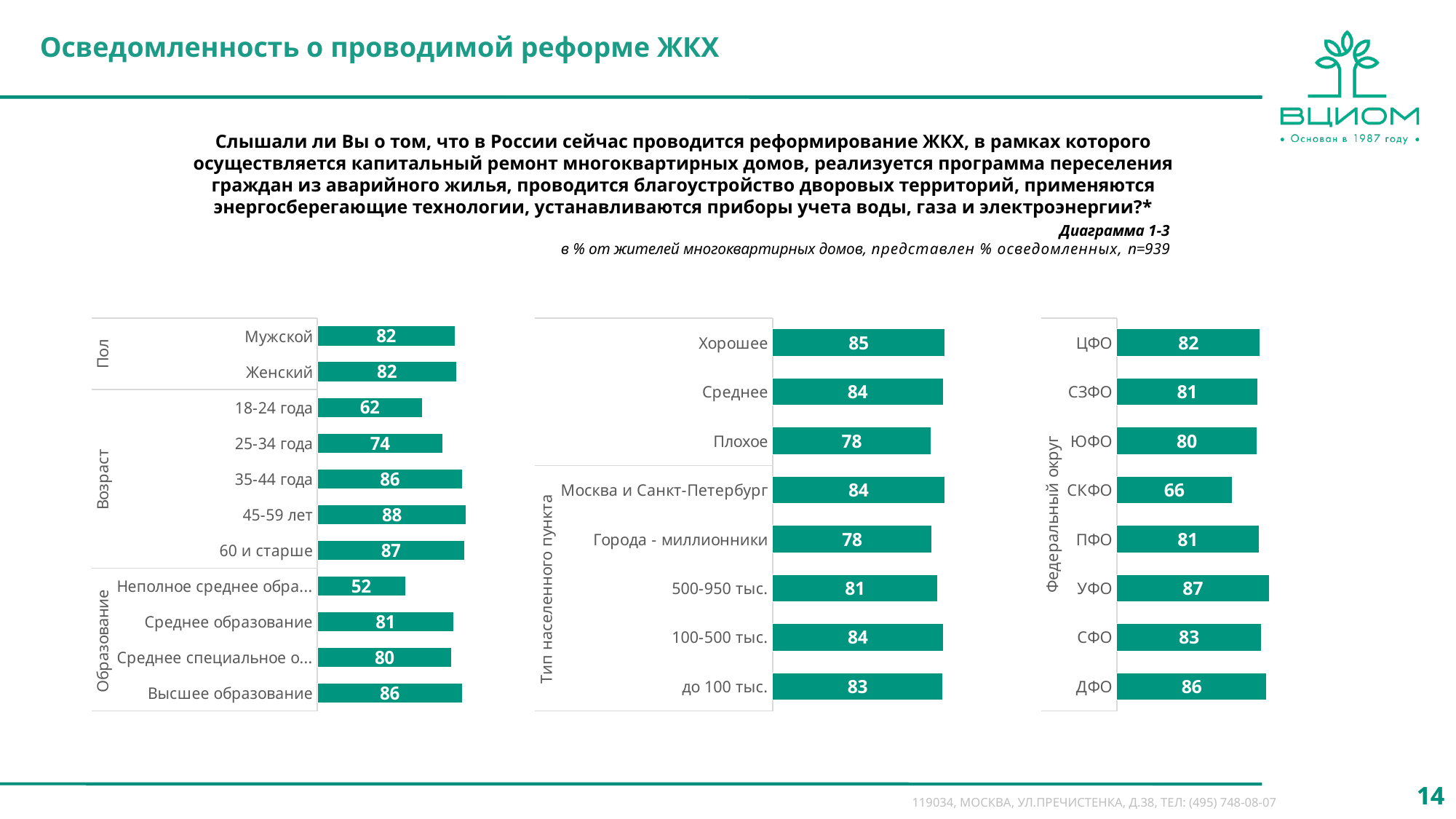
What type of chart is used on this slide? Bar chart In the left chart, what is the value for the 18-24 года age group? 62 In the left chart, what is the difference between the values for 45-59 лет and 18-24 года? 26 In the middle chart, what is the value for Москва и Санкт-Петербург? 84 In the left chart, which category has the lowest value? Неполное среднее обра... In the middle chart, what is the value for Города - миллионники? 78 How many federal districts are shown in the right chart? 8 In the right chart (Федеральный округ), what is the difference between the values for УФО and СКФО? 21 In the middle chart, which is larger: the value for Хорошее or the value for Плохое? Хорошее In the right chart (Федеральный округ), which federal district has the highest value? УФО In the right chart (Федеральный округ), which federal district has the lowest value? СКФО In the left chart, which age group has the highest value? 45-59 лет